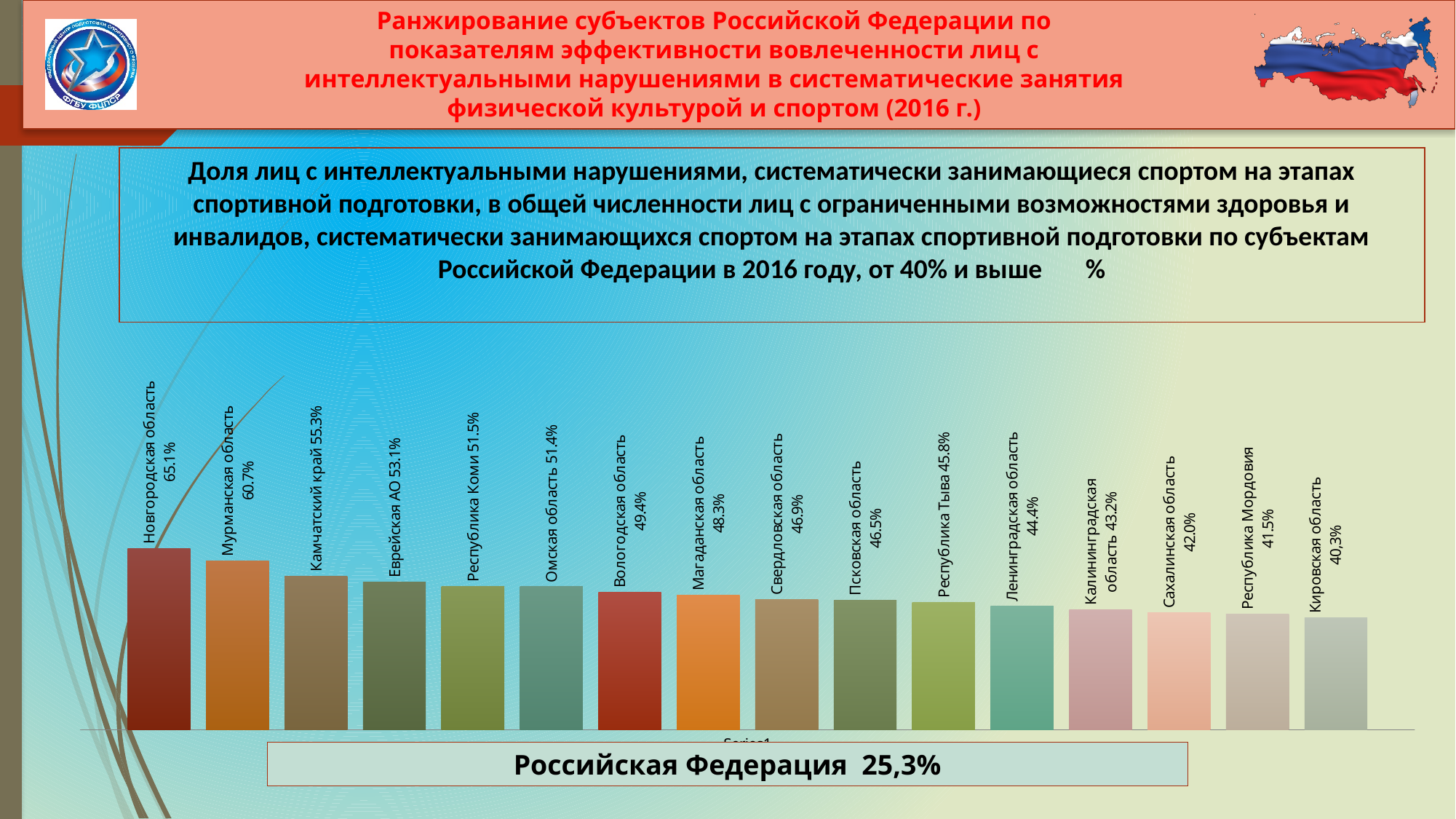
What kind of chart is shown on the slide? Bar chart Do the values rise or fall from left to right across the chart? Fall How many regions are shown as bars in the chart? 16 Which region has the lowest value in the chart? Кировская область What value is shown for Ленинградская область? 44.4% Which region has the highest value in the chart? Новгородская область Which is larger, the value for Камчатский край or the value for Вологодская область? Камчатский край What value is shown for Новгородская область? 65.1% What value is shown for Кировская область? 40,3% What value is given for the Российская Федерация in the box below the chart? 25,3% What value is shown for Республика Коми? 51.5% What is the difference between the values for Новгородская область and Мурманская область? 4.4%